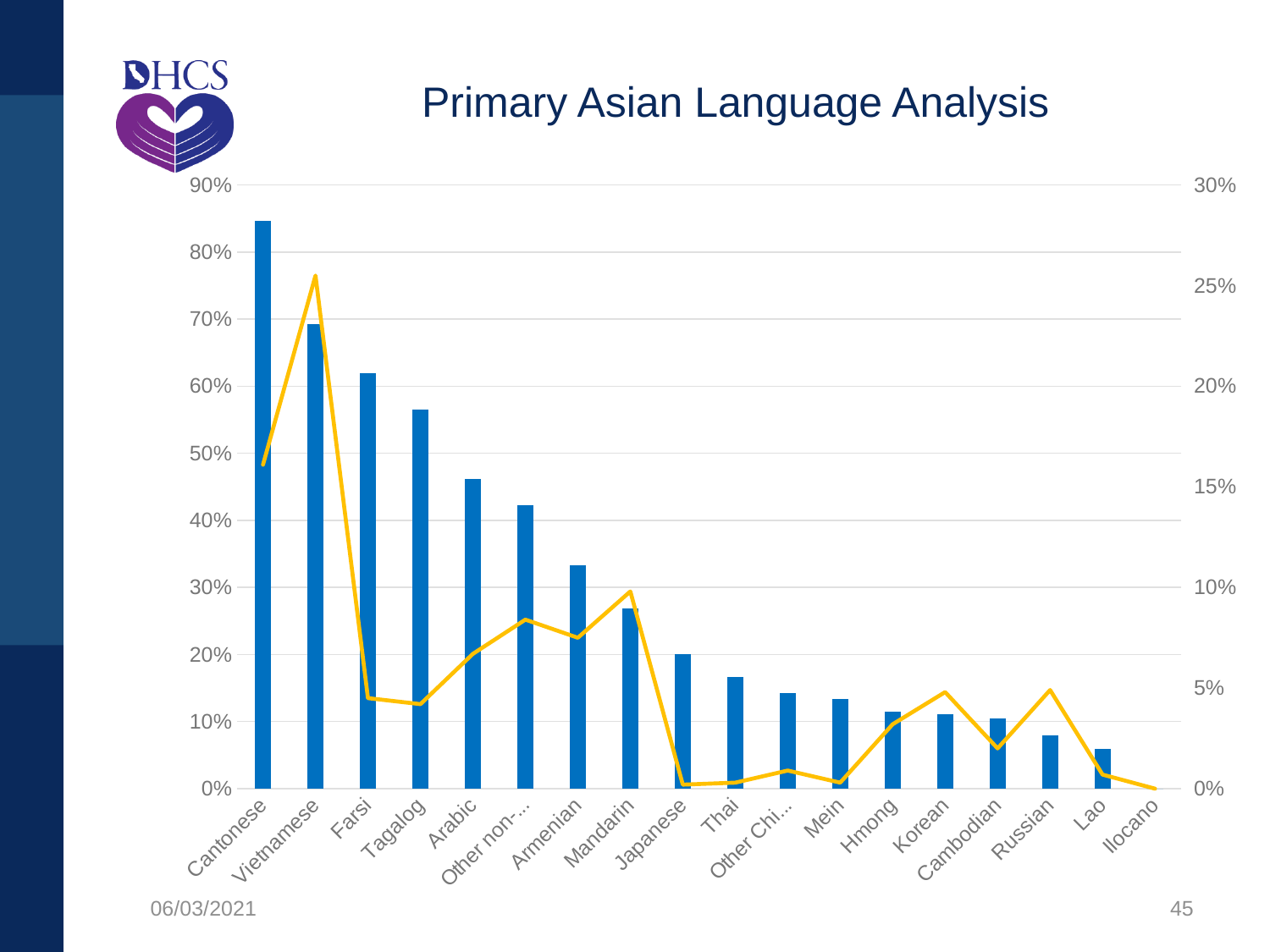
What is the highest tick value shown on the right-hand axis? 30% Is the bar for Tagalog greater or less than 60%? less At which language does the yellow line reach its highest point? Vietnamese Is the bar for Arabic greater or less than 40%? greater Is the bar for Thai greater or less than 20%? less How many language categories are shown along the x axis? 18 Do the bar values generally rise or fall moving from left to right along the x axis? Fall Which language has the tallest bar? Cantonese Which has the taller bar, Armenian or Mandarin? Armenian Which has the taller bar, Farsi or Tagalog? Farsi What kind of chart is shown on the slide? A bar chart combined with a line chart